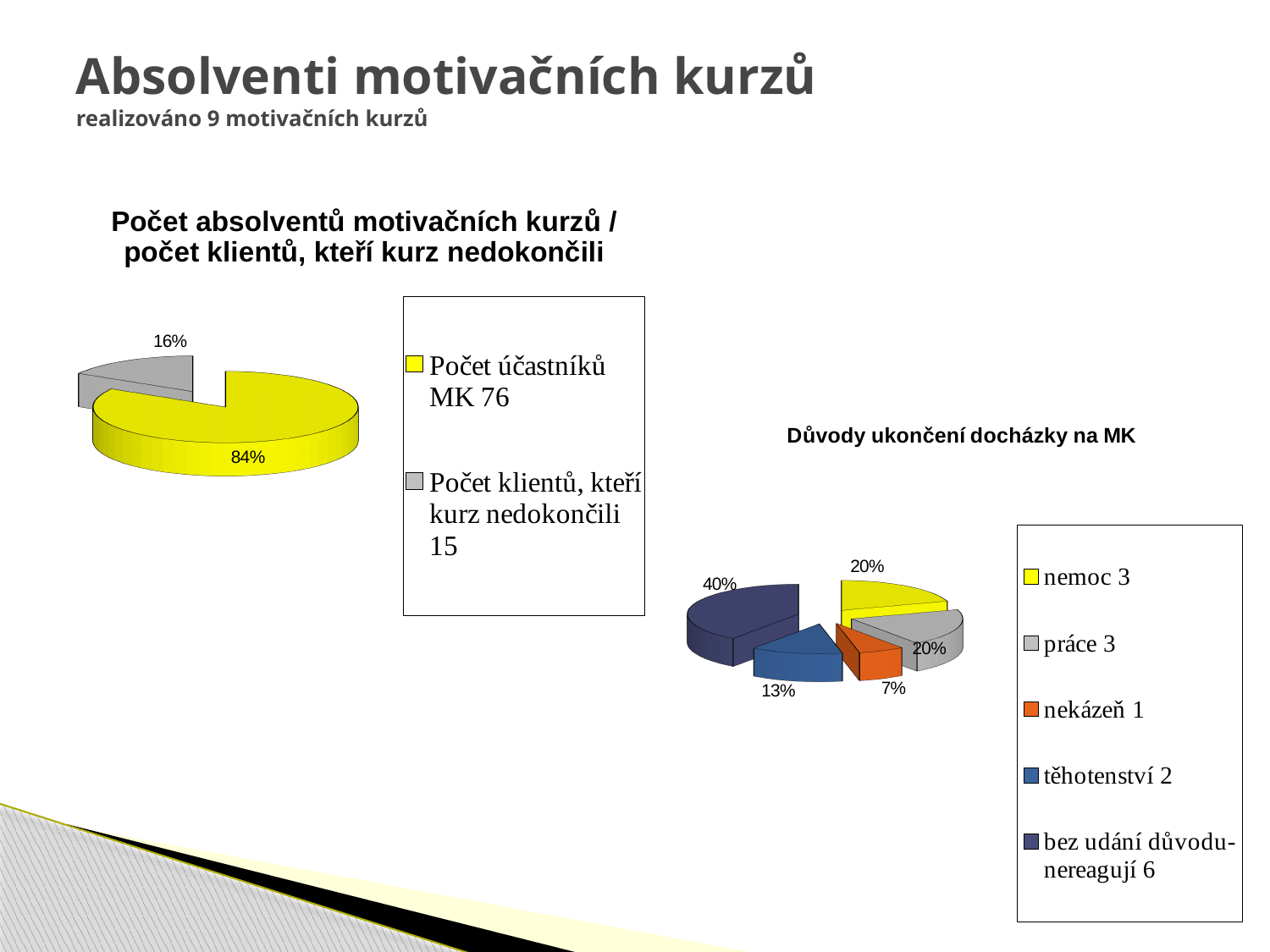
In the chart titled "Důvody ukončení docházky na MK", which category has the smallest slice? nekázeň 1 In the chart titled "Důvody ukončení docházky na MK", what share of the pie is labelled for "bez udání důvodu-nereagují 6"? 40% In the chart titled "Počet absolventů motivačních kurzů / počet klientů, kteří kurz nedokončili", what share of the pie is labelled for "Počet klientů, kteří kurz nedokončili 15"? 16% What kind of chart is the chart titled "Důvody ukončení docházky na MK"? pie chart How many categories does the legend of the chart titled "Důvody ukončení docházky na MK" list? 5 How many slices does the chart titled "Počet absolventů motivačních kurzů / počet klientů, kteří kurz nedokončili" have? 2 In the chart titled "Důvody ukončení docházky na MK", which colour is the slice for "nekázeň 1"? orange In the chart titled "Počet absolventů motivačních kurzů / počet klientů, kteří kurz nedokončili", what share of the pie is labelled for "Počet účastníků MK 76"? 84% In the chart titled "Důvody ukončení docházky na MK", what is the difference in percentage points between the slice for "bez udání důvodu-nereagují 6" and the slice for "těhotenství 2"? 27 percentage points In the chart titled "Důvody ukončení docházky na MK", which category has the largest slice? bez udání důvodu-nereagují 6